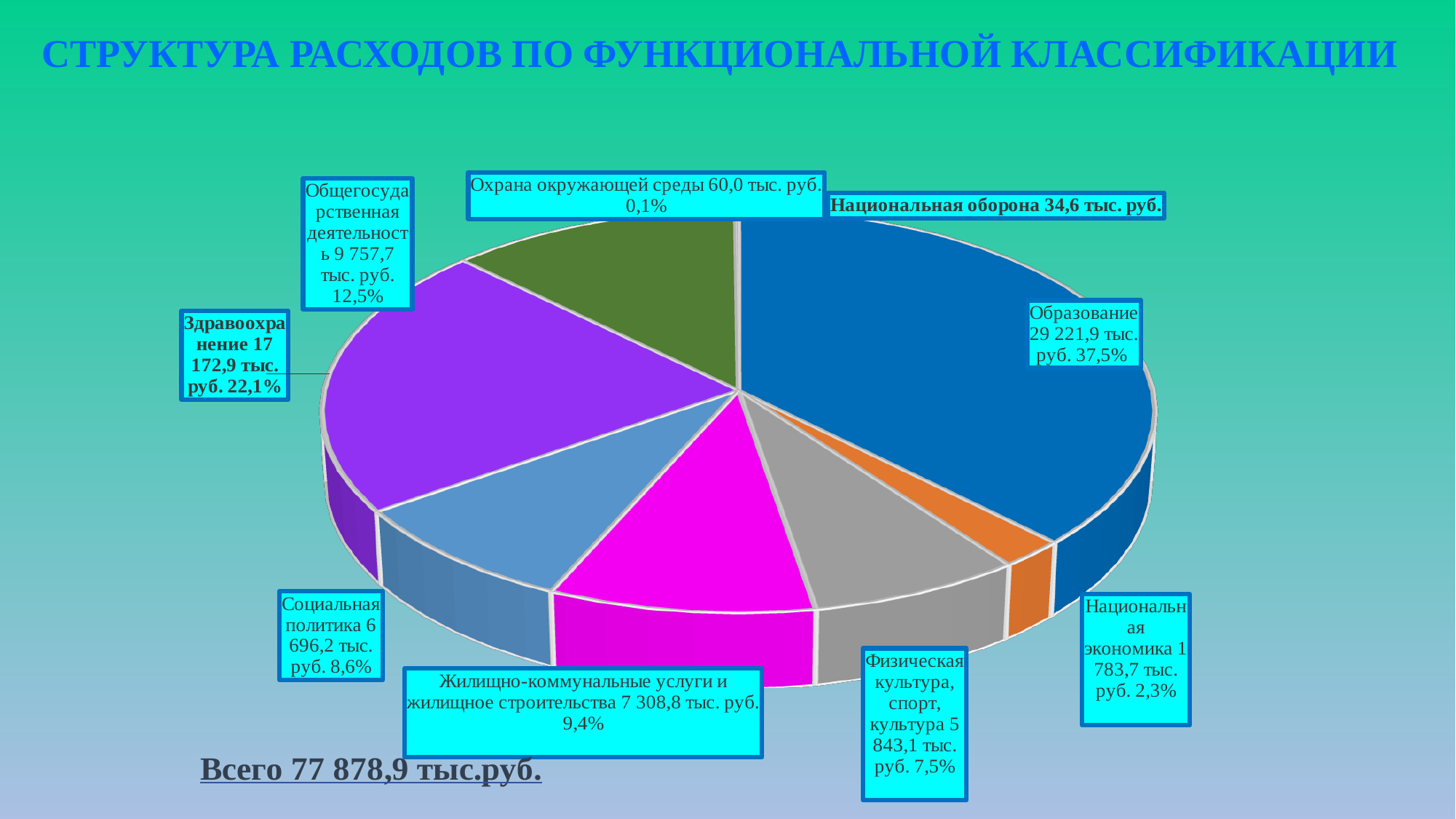
What is the total of all expenditures shown on the slide? 77 878,9 тыс.руб. What percentage is shown for Жилищно-коммунальные услуги и жилищное строительство? 9,4% What is the difference between the values for Образование and Здравоохранение? 12 049,0 тыс. руб. Which category has the smallest value? Национальная оборона What is the value for Социальная политика? 6 696,2 тыс. руб. Which category has the largest slice of the pie? Образование What kind of chart is shown on the slide? pie chart Which is larger, Социальная политика or Физическая культура, спорт, культура? Социальная политика What share of the pie does Здравоохранение take? 22,1% What is the value for Образование? 29 221,9 тыс. руб. What is the title of the slide? СТРУКТУРА РАСХОДОВ ПО ФУНКЦИОНАЛЬНОЙ КЛАССИФИКАЦИИ How many categories are shown in the pie chart? 9